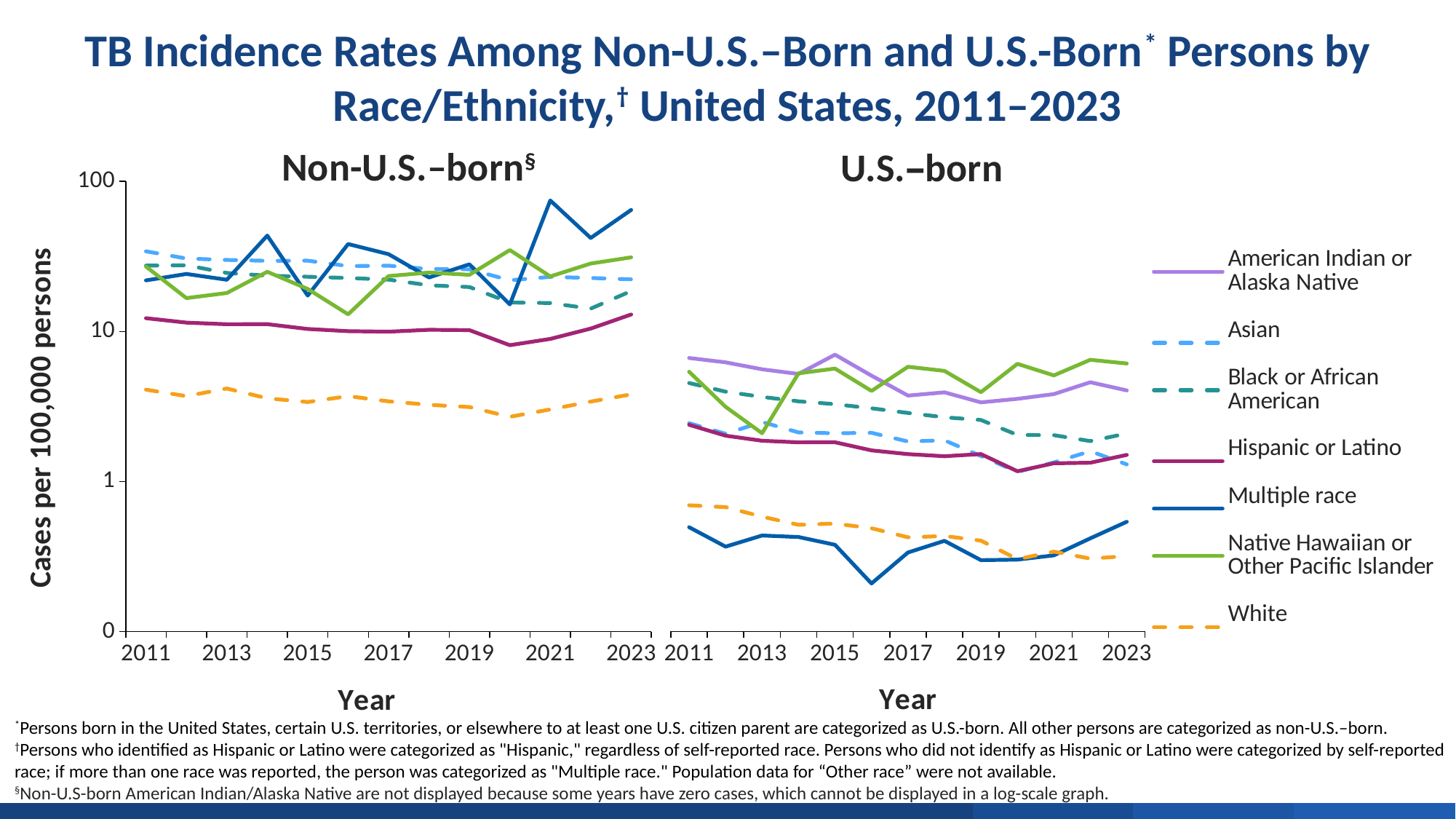
In the U.S.-born chart, which is larger in 2011: Hispanic or Latino or White? Hispanic or Latino In the Non-U.S.-born chart, which series has the lowest value in 2011? White In the Non-U.S.-born chart, is the value for Multiple race in 2021 greater or less than 10? greater In the U.S.-born chart, is the value for American Indian or Alaska Native in 2015 greater or less than 10? less In the U.S.-born chart, does the Black or African American line rise or fall from 2011 to 2023? Fall What kind of chart is used in the Non-U.S.-born panel? Line chart How many series does the legend list? 7 In the U.S.-born chart, is the value for White in 2011 greater or less than 1? less Which legend series is not displayed in the Non-U.S.-born chart? American Indian or Alaska Native In the U.S.-born chart, which series has the lowest value in 2016? Multiple race In the Non-U.S.-born chart, which series has the highest value in 2021? Multiple race